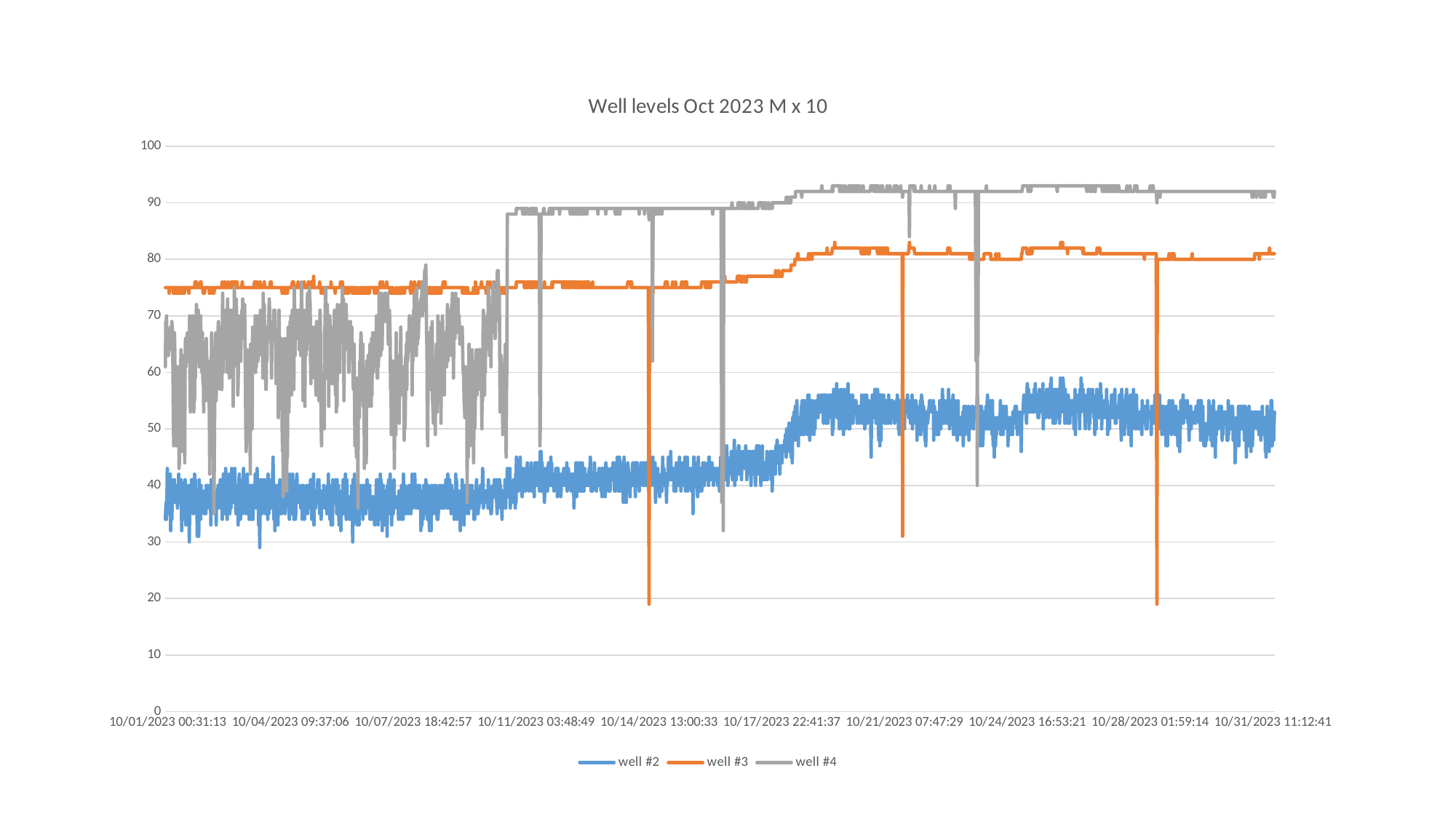
Does the level of well #3 rise or fall from the start of October to the end of October? rise Is the value for well #2 around 10/14/2023 greater or less than 60? less Is the value for well #3 at the start of the chart (10/01/2023) greater or less than 70? greater Is the value for well #2 at the end of the chart (10/31/2023) greater or less than 40? greater Which series is drawn in orange? well #3 Which series has the highest values at the end of the month (10/31/2023)? well #4 What kind of chart is shown on the slide? line chart Which series has the lowest values throughout the chart? well #2 How many series does the legend list? 3 Which is larger around 10/21/2023: the value for well #3 or the value for well #2? well #3 What is the title of the chart? Well levels Oct 2023 M x 10